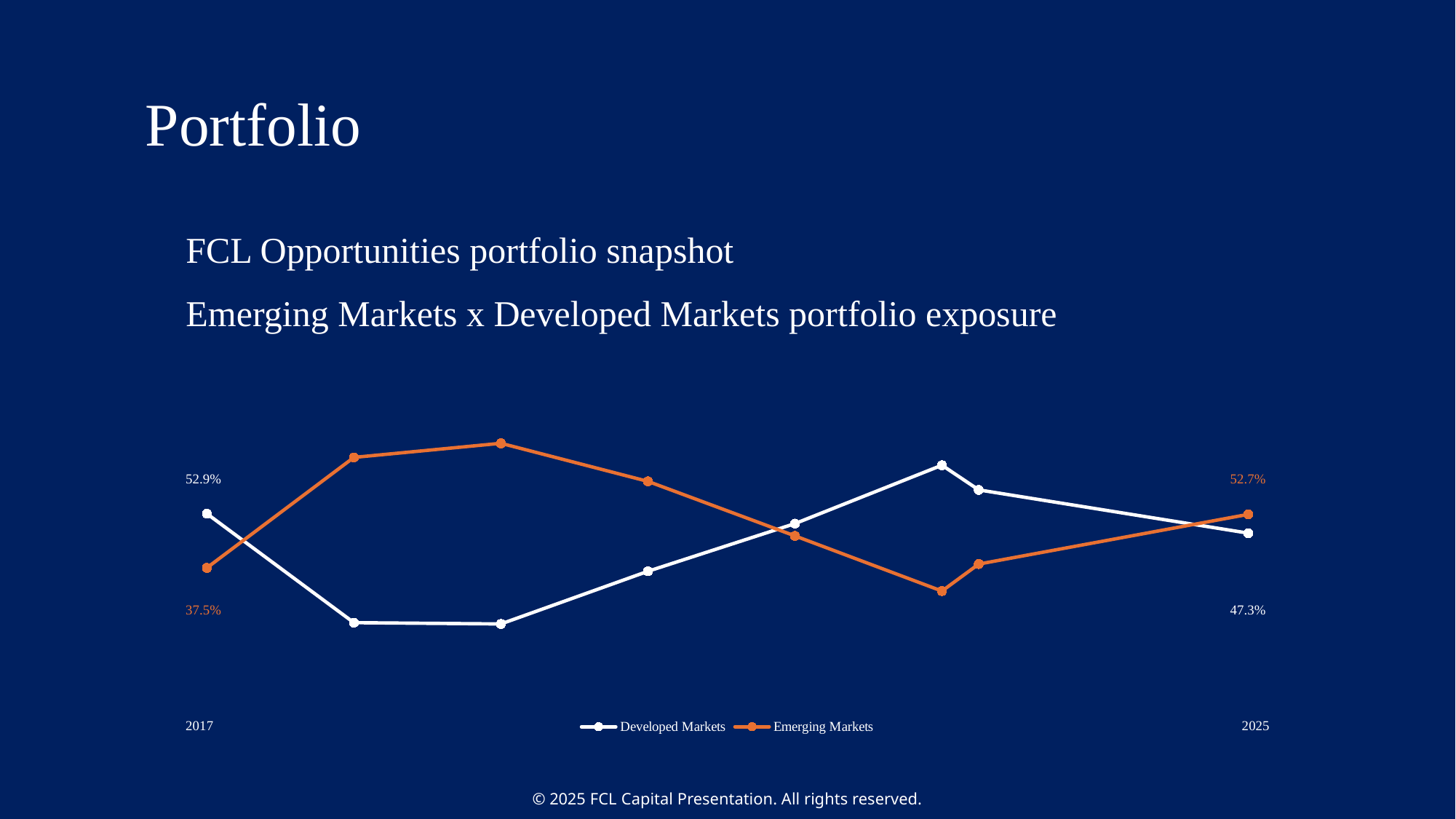
What is the Emerging Markets exposure in 2025? 52.7% What kind of chart is shown on the slide? Line chart Does the Developed Markets exposure rise or fall from 2017 to 2025? Fall What is the difference between the Developed Markets and Emerging Markets exposure in 2017? 15.4 percentage points What colour is the Emerging Markets line? Orange What is the difference between the Emerging Markets and Developed Markets exposure in 2025? 5.4 percentage points What is the Developed Markets exposure in 2025? 47.3% What is the Emerging Markets exposure in 2017? 37.5% What is the Developed Markets exposure in 2017? 52.9% How many series does the chart legend list? 2 In 2025, which series has the larger exposure, Developed Markets or Emerging Markets? Emerging Markets In 2017, which series has the larger exposure, Developed Markets or Emerging Markets? Developed Markets